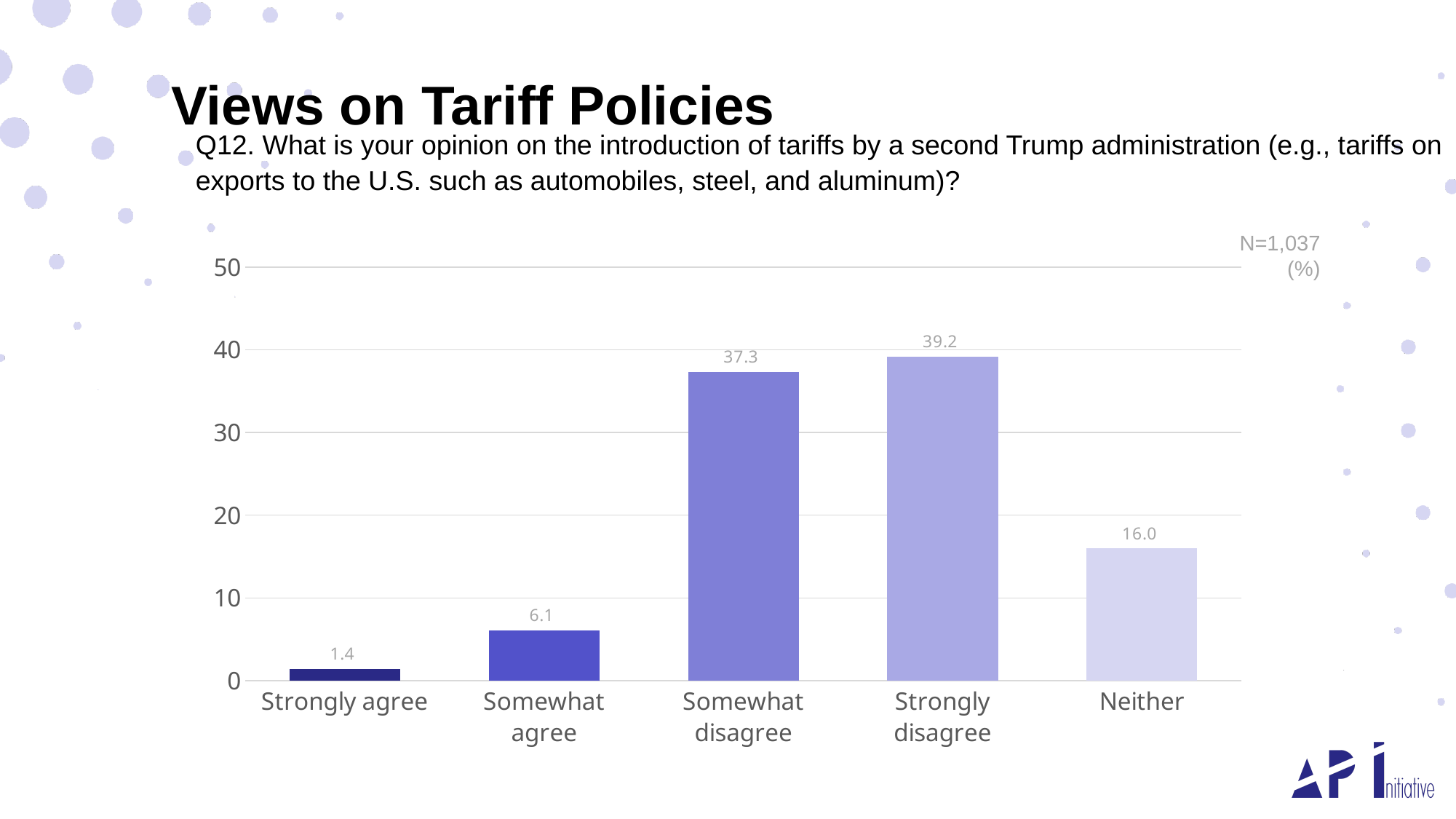
What is the value for Strongly disagree? 39.2 Which category has the lowest value? Strongly agree What is the value for Neither? 16.0 Which category has the highest value? Strongly disagree What sample size (N) is shown on the chart? N=1,037 What is the difference between the values for Strongly disagree and Somewhat disagree? 1.9 What is the value for Strongly agree? 1.4 How many categories are shown on the x axis? 5 Which is larger, the value for Neither or the value for Somewhat agree? Neither What kind of chart is shown on the slide? Bar chart What is the value for Somewhat disagree? 37.3 What is the value for Somewhat agree? 6.1